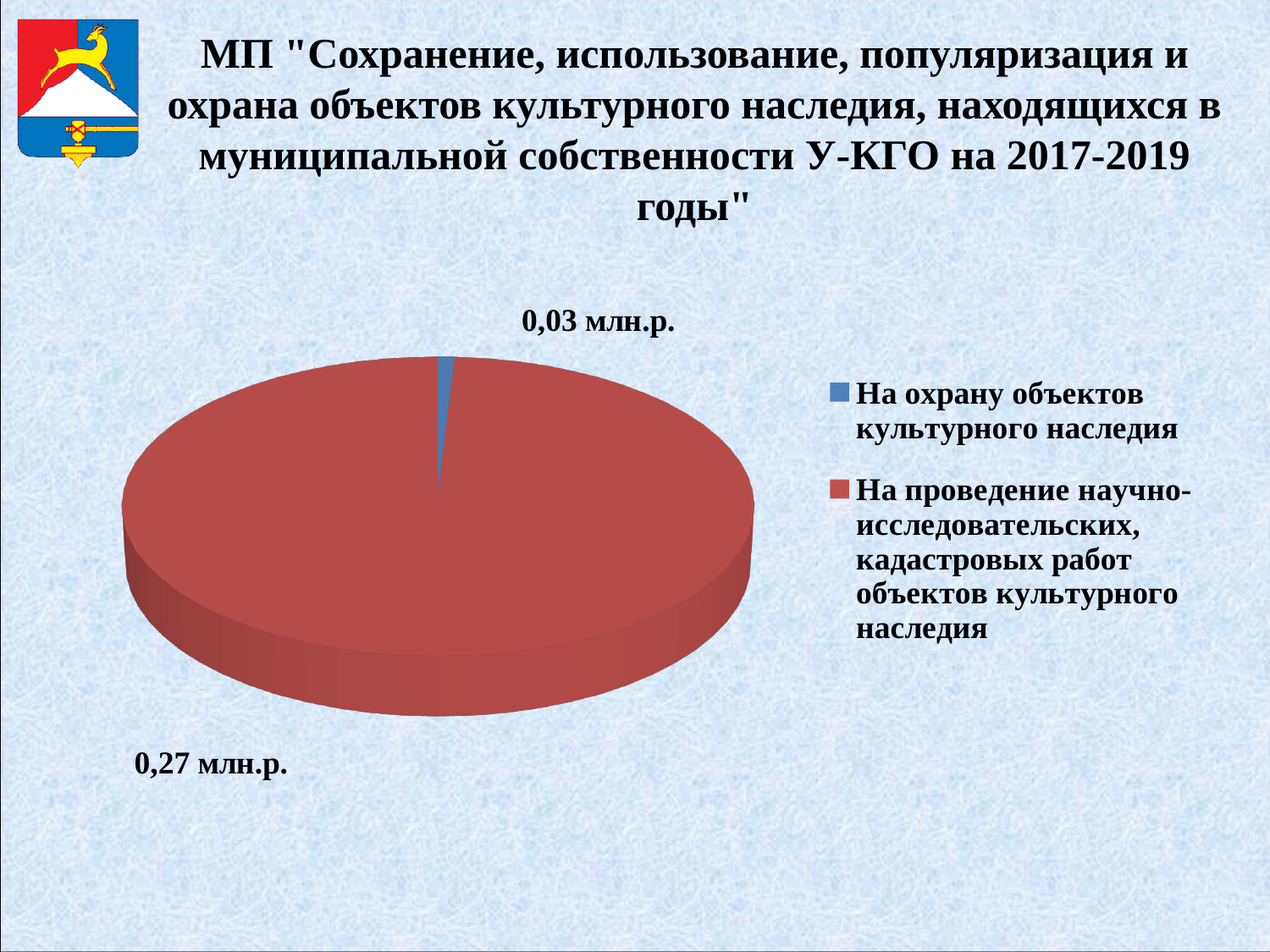
How many entries does the legend list? 2 What kind of chart is shown on the slide? Pie chart What is the value for "На проведение научно-исследовательских, кадастровых работ объектов культурного наследия"? 0,27 млн.р. What is the difference between the value for "На проведение научно-исследовательских, кадастровых работ объектов культурного наследия" and the value for "На охрану объектов культурного наследия"? 0,24 млн.р. What colour is the slice for "На охрану объектов культурного наследия"? Blue What is the value for "На охрану объектов культурного наследия"? 0,03 млн.р. How many slices does the pie chart have? 2 What is the total of the two values shown on the pie chart? 0,30 млн.р. Which category has the smallest slice of the pie? На охрану объектов культурного наследия Which category has the largest slice of the pie? На проведение научно-исследовательских, кадастровых работ объектов культурного наследия Which is larger: the value for "На охрану объектов культурного наследия" or the value for "На проведение научно-исследовательских, кадастровых работ объектов культурного наследия"? На проведение научно-исследовательских, кадастровых работ объектов культурного наследия